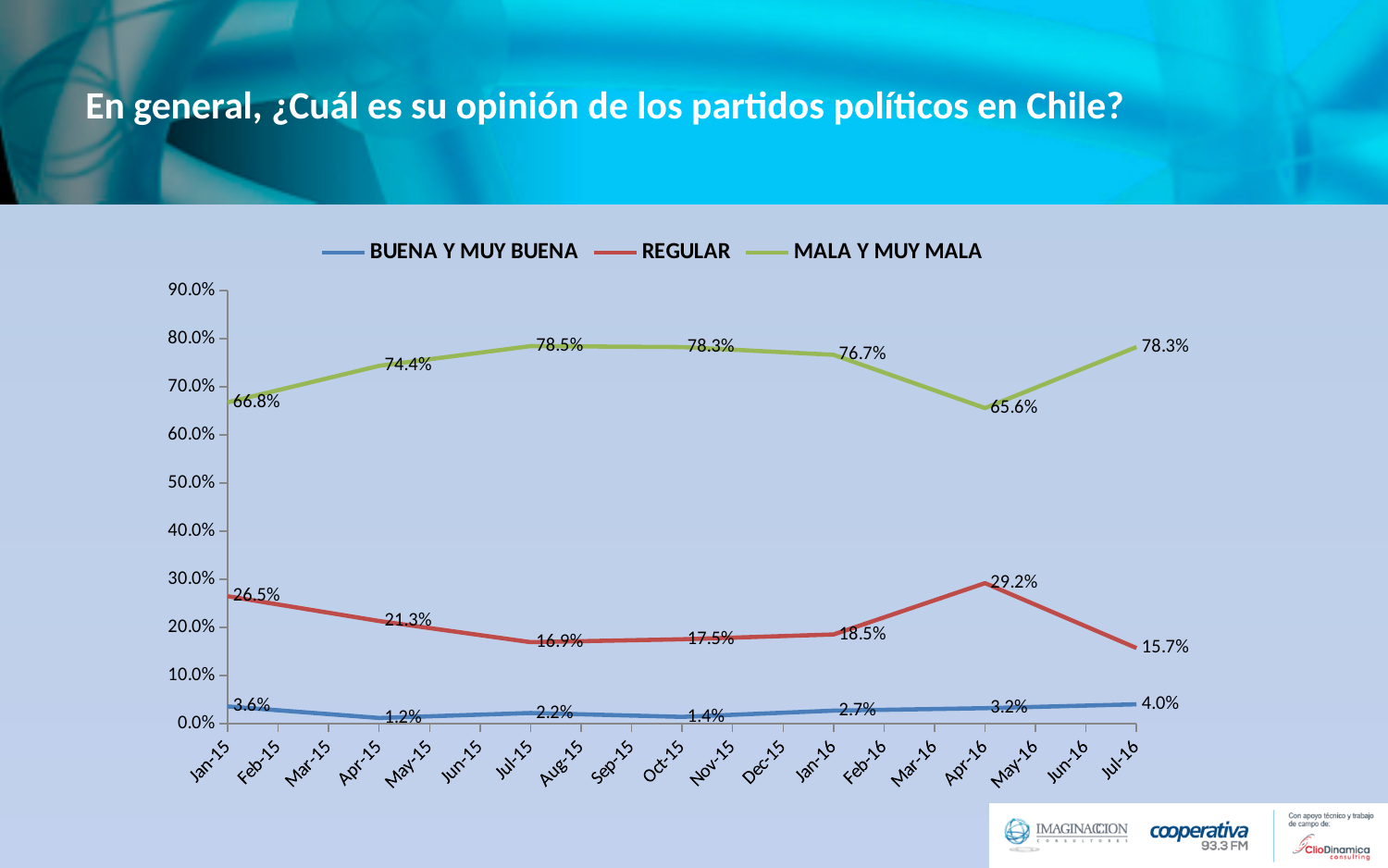
How many labelled data points does the BUENA Y MUY BUENA series have? 7 What is the value for REGULAR in Apr-16? 29.2% What type of chart is shown on the slide? line chart Is the value for MALA Y MUY MALA in Jan-15 greater or less than 70.0%? less In which month does the REGULAR series reach its highest value? Apr-16 What is the value for BUENA Y MUY BUENA in Jul-16? 4.0% Which is larger: the REGULAR value in Jan-15 or in Jan-16? Jan-15 What colour is the line for REGULAR? red What is the difference between the MALA Y MUY MALA value in Jul-16 and in Apr-16? 12.7% In which month does the MALA Y MUY MALA series reach its lowest value? Apr-16 What is the value for MALA Y MUY MALA in Jul-15? 78.5% How many series does the legend list? 3